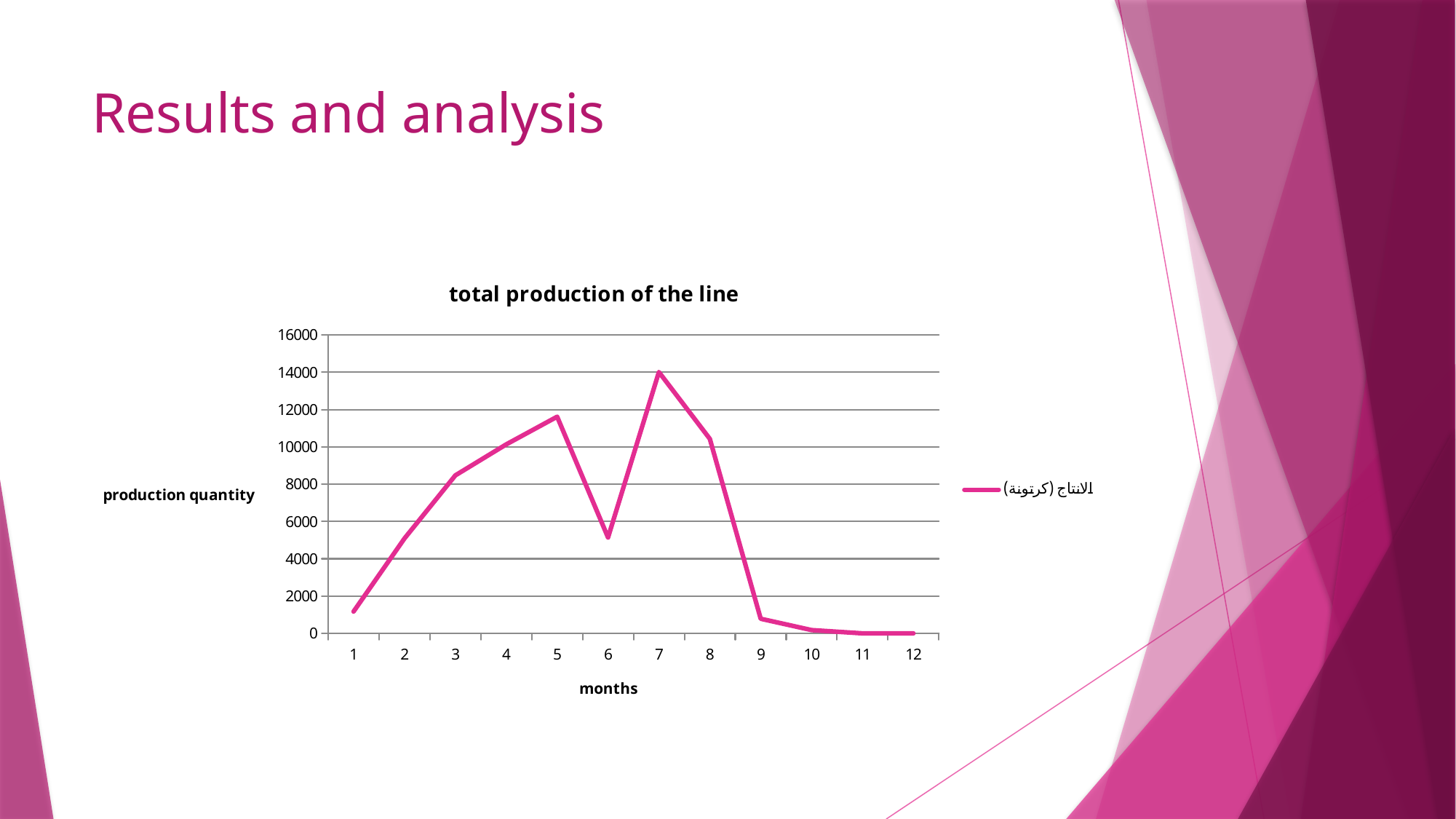
Is the value for month 1 greater or less than 2000? less What is the title of the chart? total production of the line In which month is production highest? 7 Is the value for month 7 greater or less than 12000? greater How many series does the legend list? 1 What is the label on the x axis of the chart? months Which month has the larger value, month 3 or month 6? month 3 How many months are plotted along the x axis? 12 Is the value for month 6 greater or less than 6000? less What kind of chart is shown on the slide? line chart Do the values rise or fall from month 8 to month 12? fall